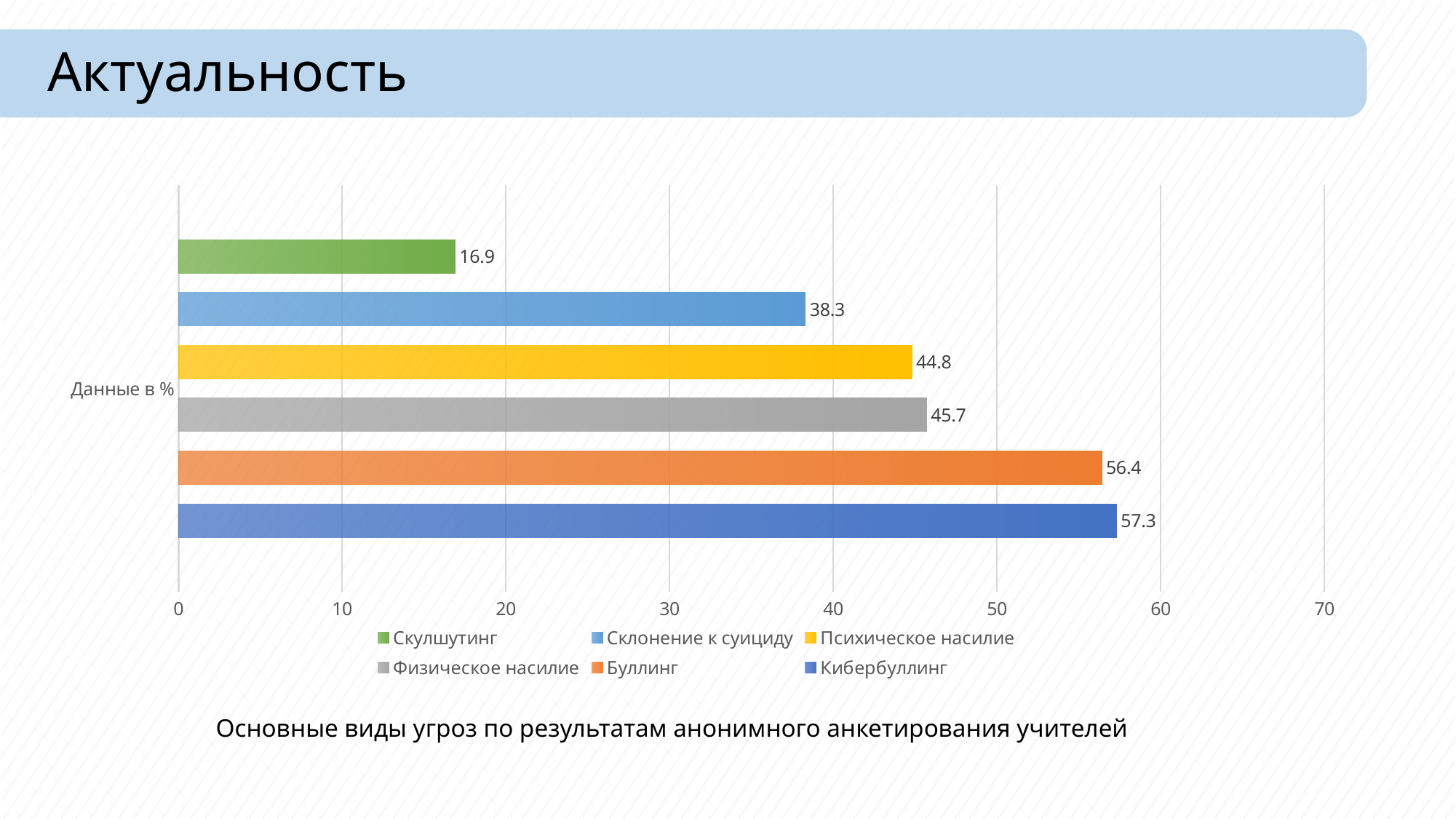
Which series has the highest value? Кибербуллинг What is the difference between the values for Буллинг and Скулшутинг? 39.5 What value is shown for Скулшутинг? 16.9 How many series does the legend list? 6 What value is shown for Психическое насилие? 44.8 What kind of chart is shown on the slide? Bar chart Which is larger, the value for Склонение к суициду or the value for Психическое насилие? Психическое насилие What value is shown for Склонение к суициду? 38.3 What value is shown for Кибербуллинг? 57.3 Which series has the lowest value? Скулшутинг What is the difference between the values for Физическое насилие and Психическое насилие? 0.9 What colour is the bar for Буллинг? Orange